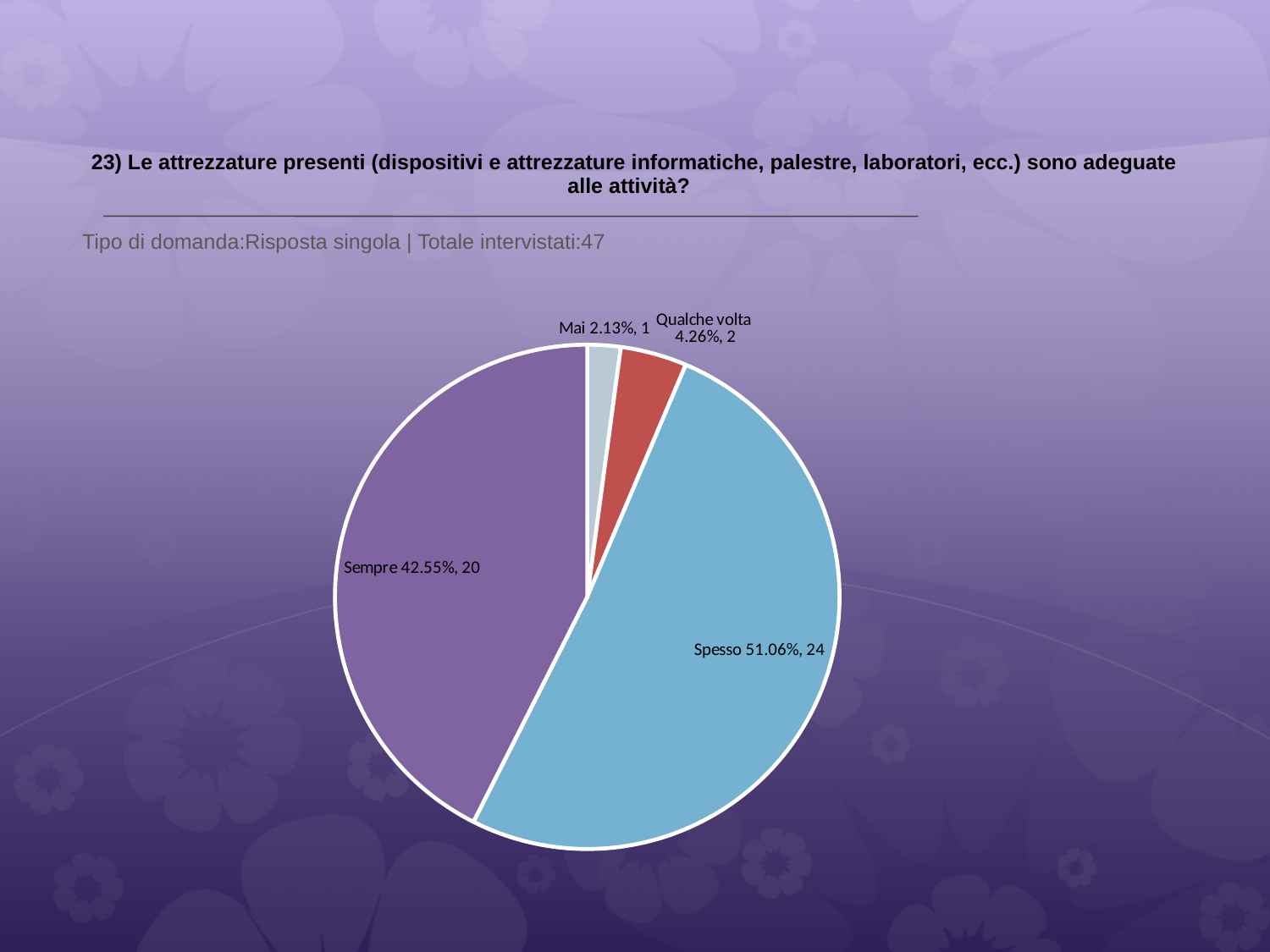
Which has more respondents, 'Qualche volta' or 'Mai'? Qualche volta What is the total number of respondents shown for the chart? 47 What kind of chart is shown on the slide? pie chart How many slices does the pie chart have? 4 Which category has the largest slice? Spesso What colour is the 'Spesso' slice? light blue How many respondents answered 'Sempre'? 20 Which category has the smallest slice? Mai What percentage share does the 'Mai' slice have? 2.13% What percentage share does the 'Spesso' slice have? 51.06% How many respondents answered 'Qualche volta'? 2 What is the difference in respondent count between 'Spesso' and 'Sempre'? 4